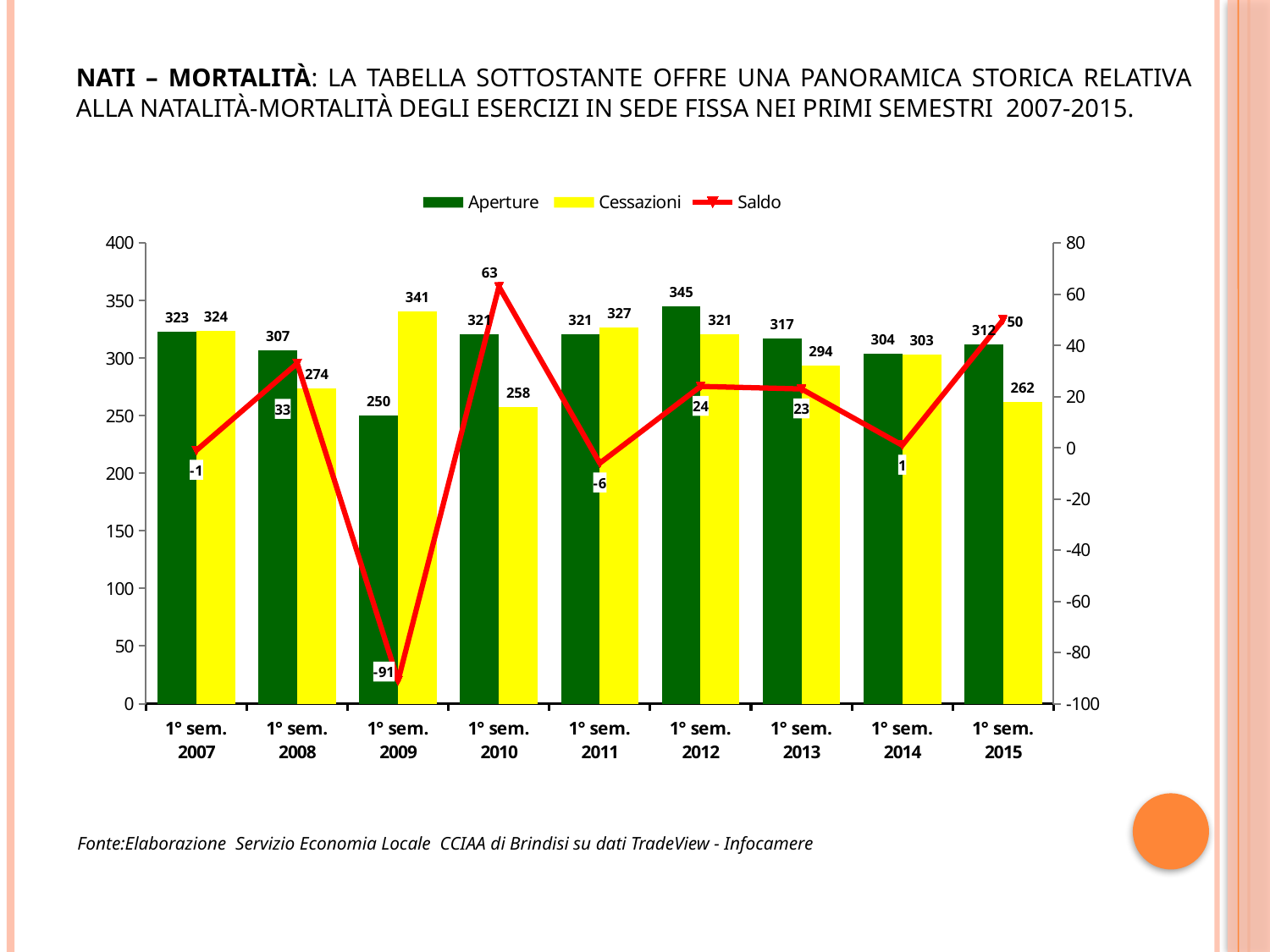
What is the Saldo value for 1° sem. 2010? 63 What is the Cessazioni value for 1° sem. 2009? 341 How many periods are shown on the x axis? 9 Which series is drawn as a red line? Saldo Which period has the lowest Cessazioni value? 1° sem. 2010 Which is larger in 1° sem. 2009, Aperture or Cessazioni? Cessazioni Which period has the highest Aperture value? 1° sem. 2012 What is the Aperture value for 1° sem. 2012? 345 What kind of chart is used for the Aperture and Cessazioni series? Bar chart What is the difference between Aperture and Cessazioni in 1° sem. 2015? 50 How many series does the legend list? 3 Which period has the lowest Saldo value? 1° sem. 2009